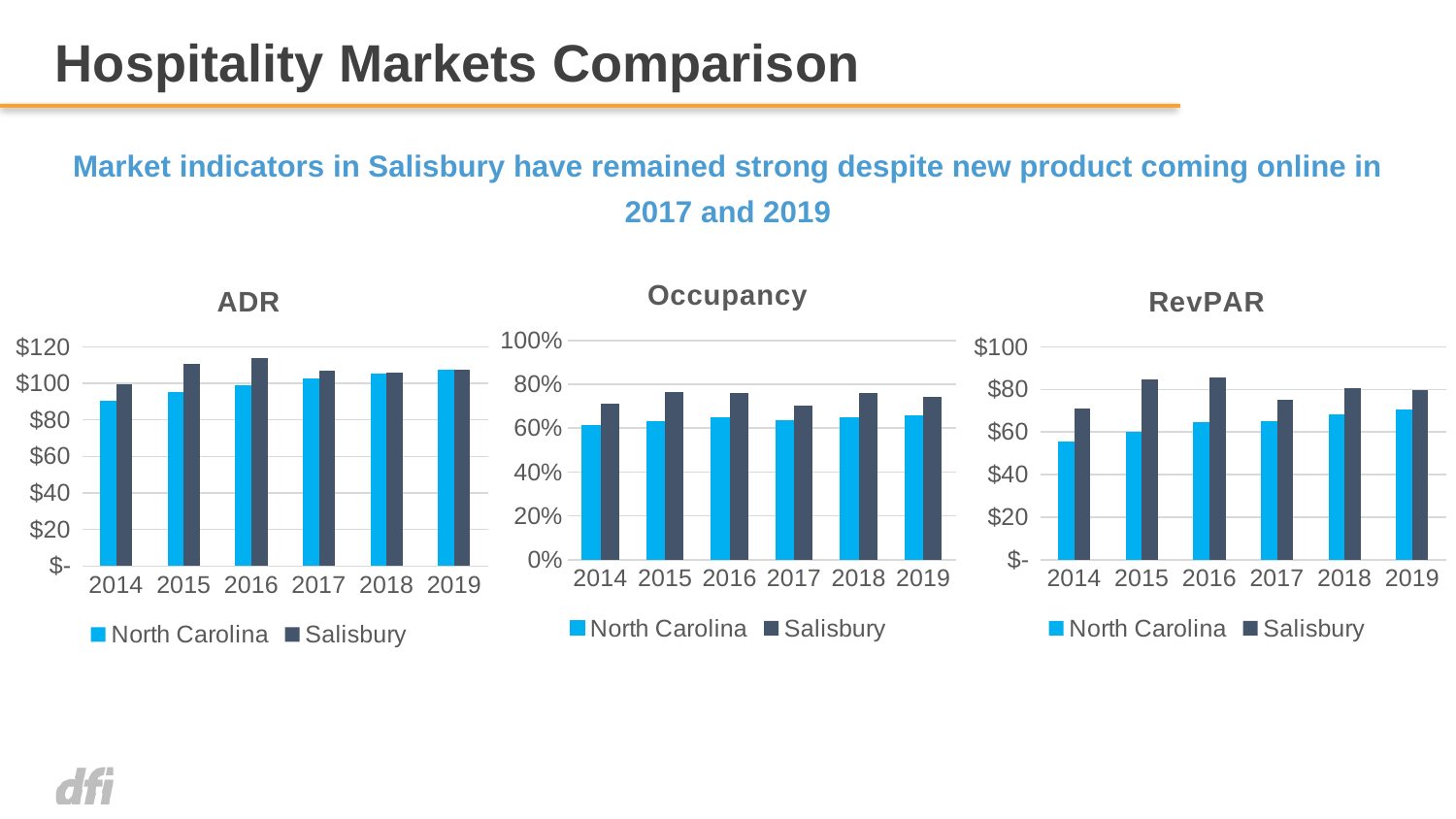
In the Occupancy chart, is the value for North Carolina in 2014 greater or less than 80%? less What are the two series listed in the legend of the ADR chart? North Carolina and Salisbury What kind of chart is the ADR chart? bar chart In the Occupancy chart, is the value for Salisbury in 2015 greater or less than 60%? greater In the Occupancy chart, which is larger in 2018, North Carolina or Salisbury? Salisbury In the ADR chart, is the value for Salisbury in 2016 greater or less than $100? greater In the RevPAR chart, which year has the lowest value for North Carolina? 2014 In the RevPAR chart, do the North Carolina values rise or fall from 2014 to 2019? rise In the Occupancy chart, how many series does the legend list? 2 In the RevPAR chart, which is larger in 2015, North Carolina or Salisbury? Salisbury In the ADR chart, how many years are shown on the x axis? 6